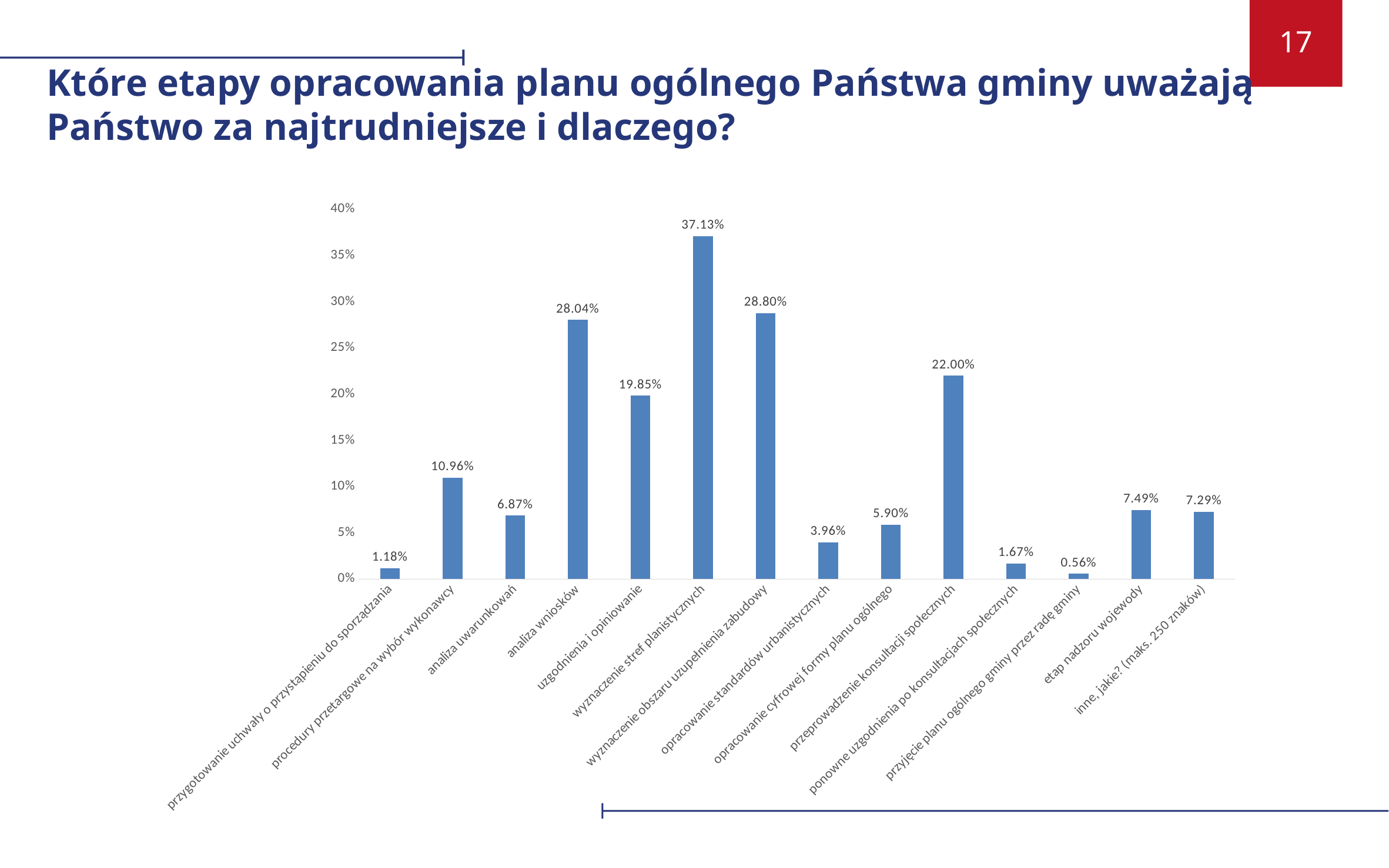
Which is larger: the value for 'analiza wniosków' or the value for 'wyznaczenie obszaru uzupełnienia zabudowy'? wyznaczenie obszaru uzupełnienia zabudowy What is the value for 'przeprowadzenie konsultacji społecznych'? 22.00% What is the difference between the values for 'wyznaczenie stref planistycznych' and 'wyznaczenie obszaru uzupełnienia zabudowy'? 8.33% Which is larger: the value for 'procedury przetargowe na wybór wykonawcy' or the value for 'analiza uwarunkowań'? procedury przetargowe na wybór wykonawcy How many categories are shown on the x axis of the chart? 14 What is the value for 'wyznaczenie stref planistycznych'? 37.13% What kind of chart is shown on the slide? bar chart Is the value for 'uzgodnienia i opiniowanie' greater or less than 20%? less Which category has the highest value? wyznaczenie stref planistycznych Which category has the lowest value? przyjęcie planu ogólnego gminy przez radę gminy What is the value for 'etap nadzoru wojewody'? 7.49% What is the difference between the values for 'przeprowadzenie konsultacji społecznych' and 'uzgodnienia i opiniowanie'? 2.15%